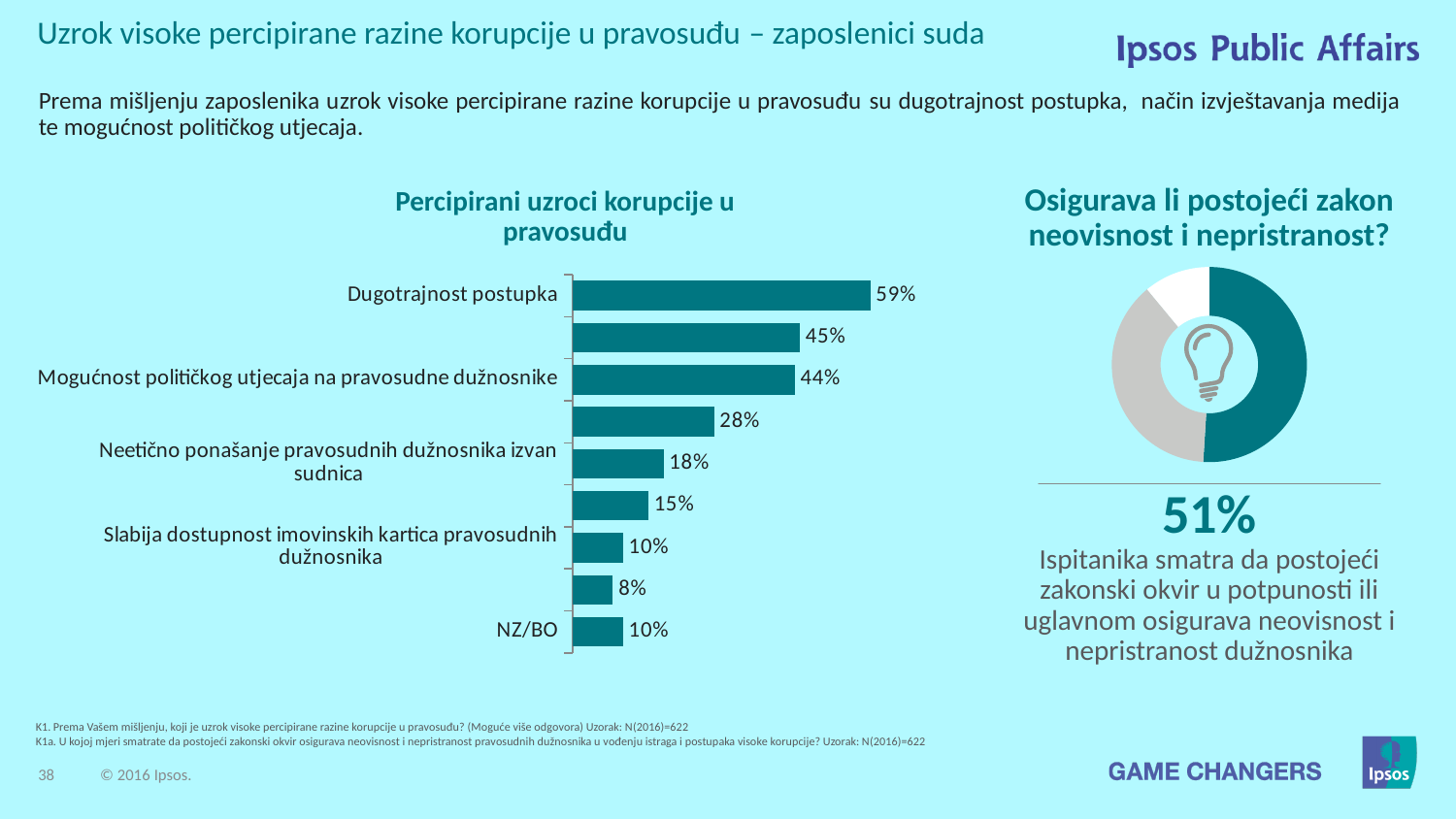
In the chart 'Percipirani uzroci korupcije u pravosuđu', what is the value for 'NZ/BO'? 10% In the chart 'Percipirani uzroci korupcije u pravosuđu', what is the difference between 'Dugotrajnost postupka' and 'Mogućnost političkog utjecaja na pravosudne dužnosnike'? 15 percentage points In the chart 'Percipirani uzroci korupcije u pravosuđu', what is the smallest value shown on any bar? 8% How many bars are plotted in the chart 'Percipirani uzroci korupcije u pravosuđu'? 9 What kind of chart is 'Percipirani uzroci korupcije u pravosuđu'? Bar chart In the chart 'Percipirani uzroci korupcije u pravosuđu', what is the value for 'Mogućnost političkog utjecaja na pravosudne dužnosnike'? 44% What kind of chart is 'Osigurava li postojeći zakon neovisnost i nepristranost?'? Donut (pie) chart In the chart 'Percipirani uzroci korupcije u pravosuđu', which is larger: 'Neetično ponašanje pravosudnih dužnosnika izvan sudnica' or 'Slabija dostupnost imovinskih kartica pravosudnih dužnosnika'? Neetično ponašanje pravosudnih dužnosnika izvan sudnica In the chart 'Percipirani uzroci korupcije u pravosuđu', what is the value for 'Neetično ponašanje pravosudnih dužnosnika izvan sudnica'? 18% In the chart 'Percipirani uzroci korupcije u pravosuđu', which category has the highest value? Dugotrajnost postupka In the chart 'Osigurava li postojeći zakon neovisnost i nepristranost?', what percentage is highlighted? 51% In the chart 'Percipirani uzroci korupcije u pravosuđu', what is the value for 'Dugotrajnost postupka'? 59%